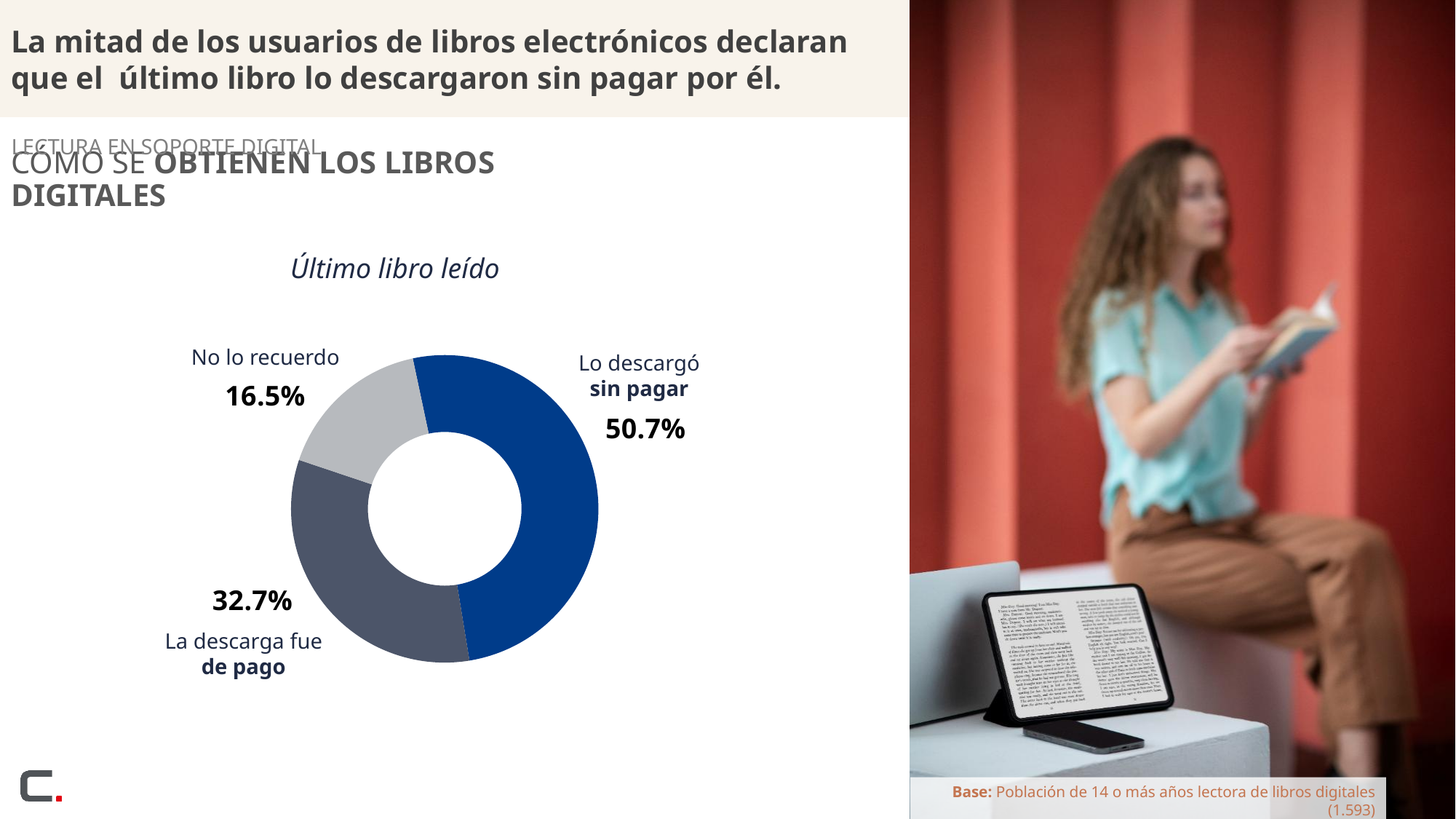
What colour is the segment for "Lo descargó sin pagar"? Blue Which category has the smallest share of the chart? No lo recuerdo What percentage of respondents said the download was paid ("La descarga fue de pago")? 32.7% How many categories are shown in the chart? 3 What percentage of respondents said they downloaded their last book without paying ("Lo descargó sin pagar")? 50.7% What is the difference in percentage points between "Lo descargó sin pagar" and "La descarga fue de pago"? 18 percentage points Which category has the largest share of the chart? Lo descargó sin pagar What is the title of the chart? Último libro leído What percentage of respondents answered "No lo recuerdo"? 16.5% What is the difference in percentage points between "La descarga fue de pago" and "No lo recuerdo"? 16.2 percentage points What kind of chart is shown on the slide? Doughnut (pie) chart Which is larger: the share for "La descarga fue de pago" or the share for "No lo recuerdo"? La descarga fue de pago